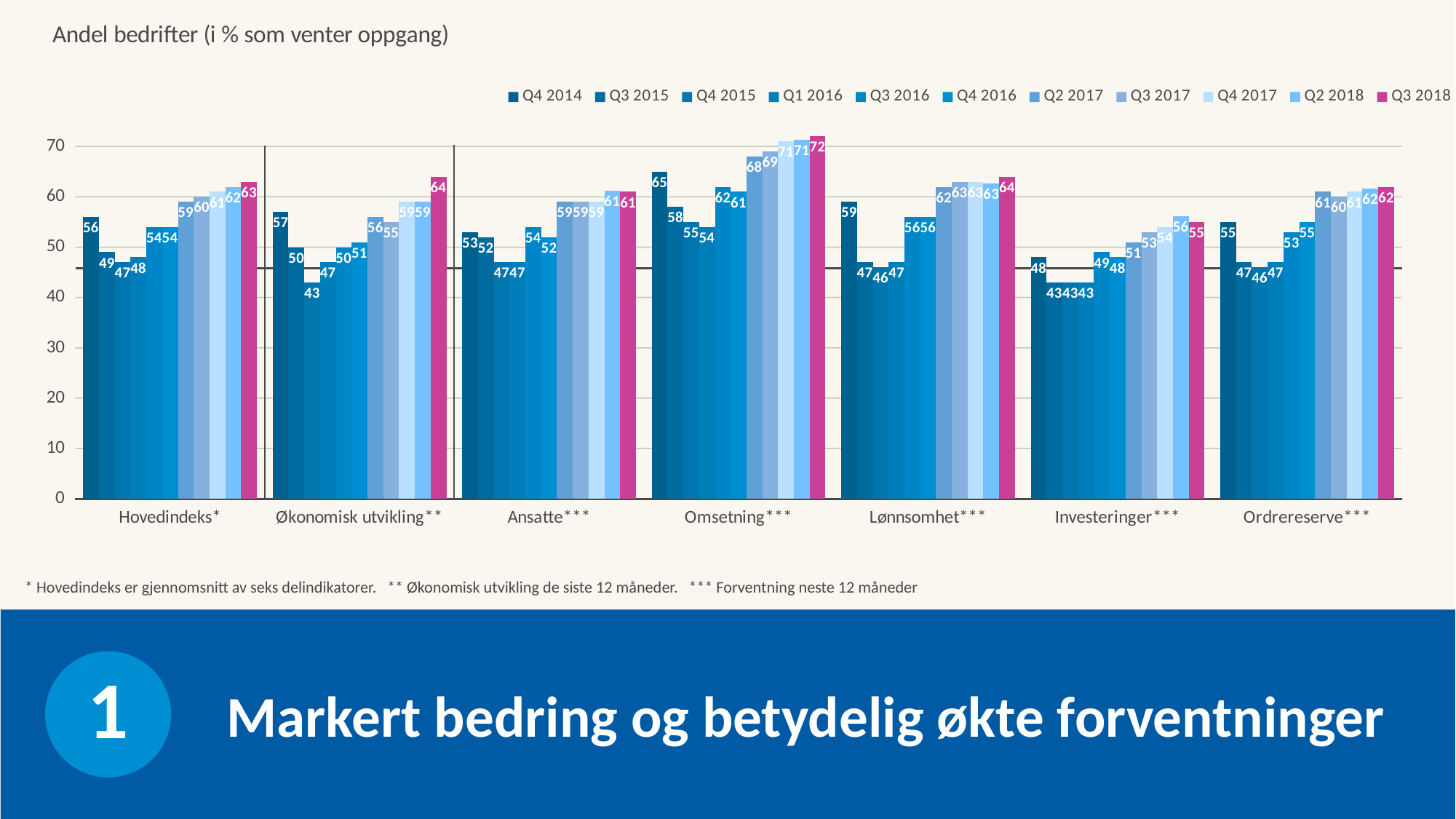
What is the value for Investeringer in Q2 2018? 56 What is the title of the chart? Andel bedrifter (i % som venter oppgang) How many series does the legend list? 11 In Q3 2018, which is larger: Lønnsomhet or Ansatte? Lønnsomhet What is the value for Økonomisk utvikling in Q4 2015? 43 How many categories are shown on the x axis? 7 What kind of chart is shown on the slide? Bar chart What is the value for Omsetning in Q3 2018? 72 Which category has the lowest value in Q3 2018? Investeringer Which category has the highest value in Q3 2018? Omsetning What is the value for Hovedindeks in Q4 2014? 56 What is the difference between the Q3 2018 and Q4 2014 values for Hovedindeks? 7